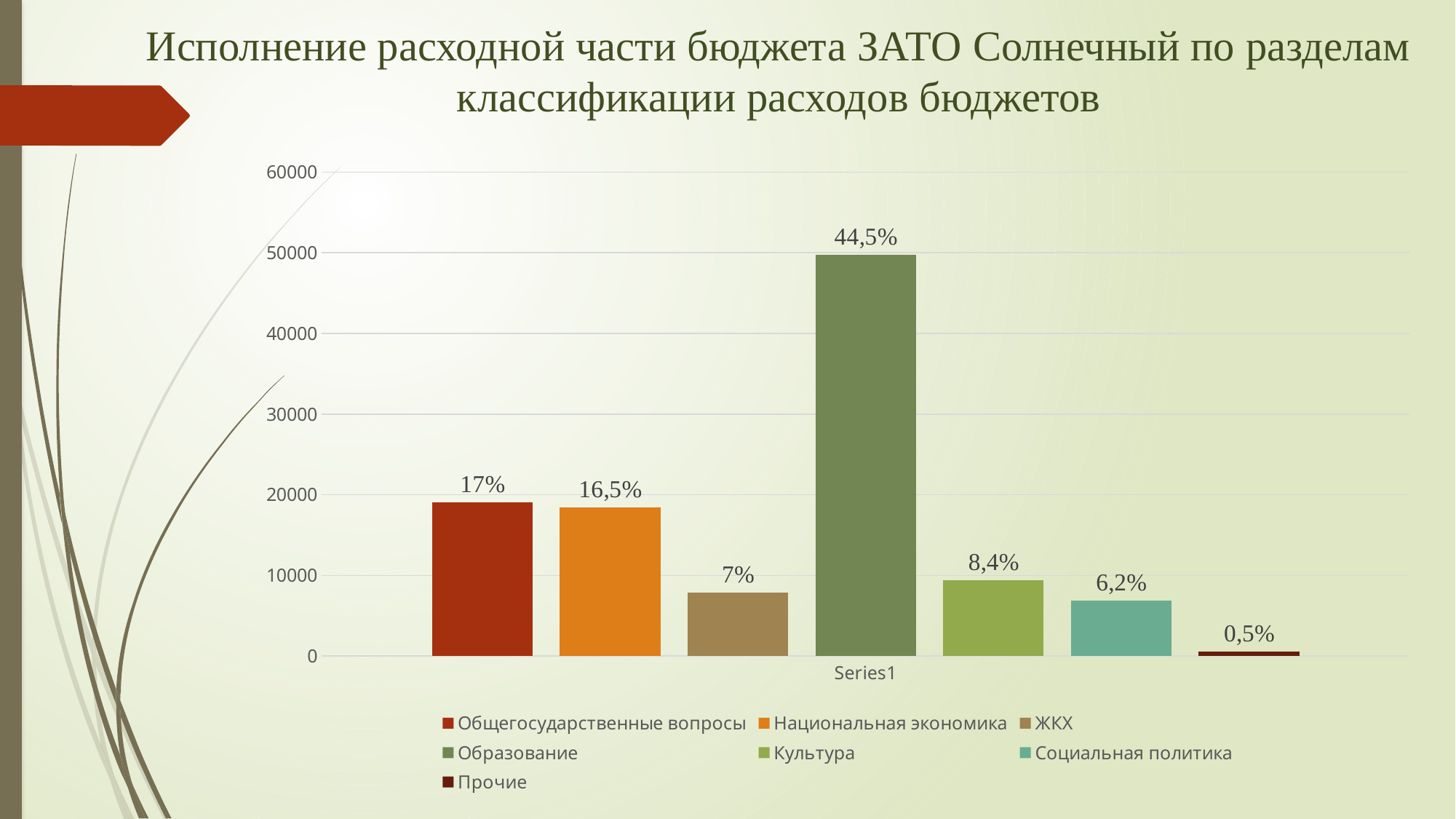
What data label is shown on the bar for Прочие? 0,5% What data label is shown on the bar for Образование? 44,5% Which legend entry has the tallest bar? Образование Is the value for Образование greater or less than 40000? greater Which bar is taller: Культура or ЖКХ? Культура What kind of chart is shown on the slide? bar chart What is the difference between the data labels for Общегосударственные вопросы and Национальная экономика? 0,5% How many series does the legend list? 7 Which legend entry has the shortest bar? Прочие Is the value for ЖКХ greater or less than 10000? less What data label is shown on the bar for Социальная политика? 6,2% What data label is shown on the bar for Национальная экономика? 16,5%